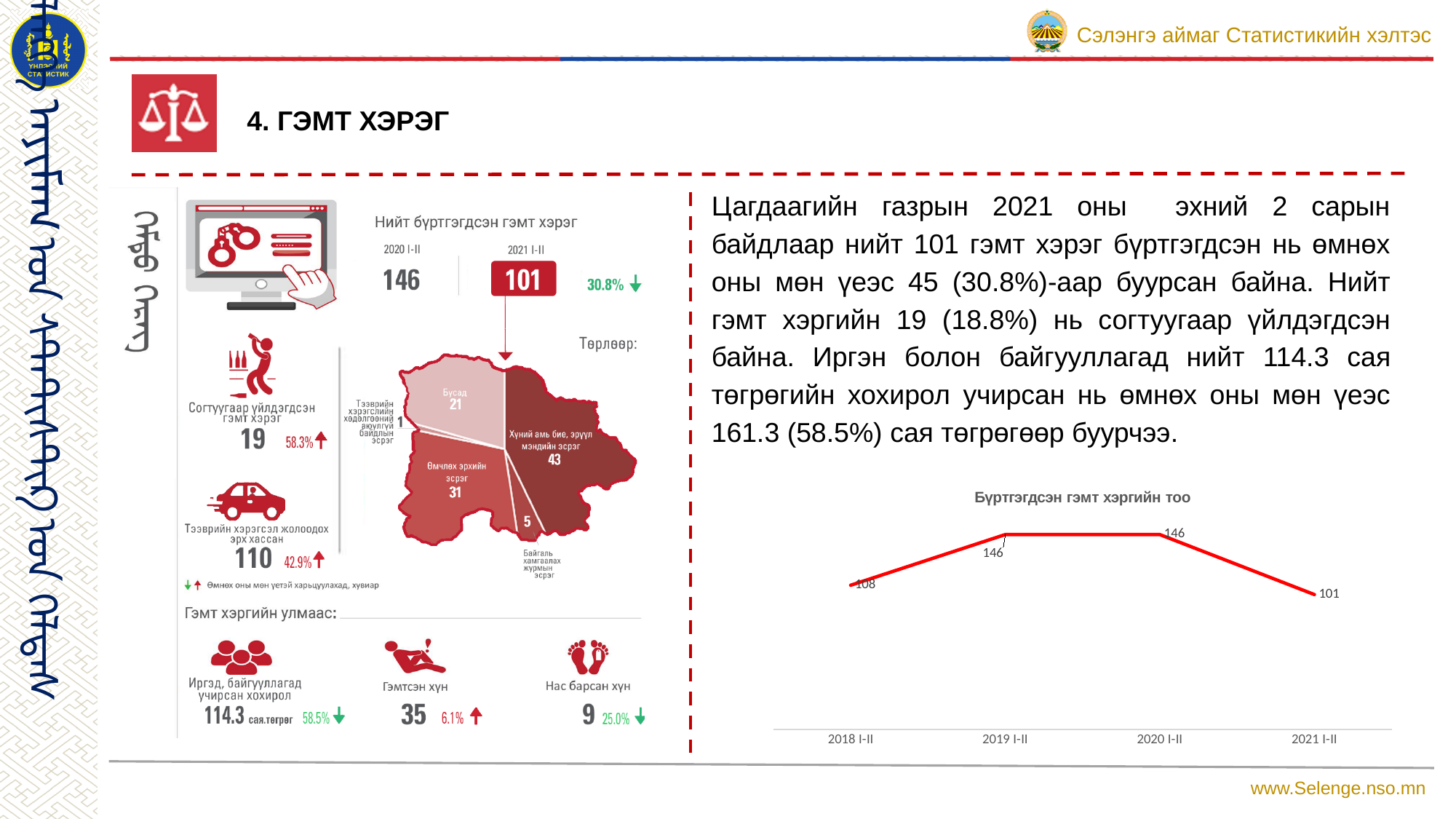
How many periods are plotted on the x axis of the 'Бүртгэгдсэн гэмт хэргийн тоо' chart? 4 In the 'Бүртгэгдсэн гэмт хэргийн тоо' chart, what is the difference between the values for 2019 I-II and 2018 I-II? 38 What kind of chart is the 'Бүртгэгдсэн гэмт хэргийн тоо' chart? line chart In the 'Бүртгэгдсэн гэмт хэргийн тоо' chart, what is the value for 2020 I-II? 146 In the 'Бүртгэгдсэн гэмт хэргийн тоо' chart, what is the value for 2018 I-II? 108 In the 'Бүртгэгдсэн гэмт хэргийн тоо' chart, which is larger: the value for 2018 I-II or 2021 I-II? 2018 I-II In the 'Бүртгэгдсэн гэмт хэргийн тоо' chart, what is the difference between the values for 2020 I-II and 2021 I-II? 45 In the 'Бүртгэгдсэн гэмт хэргийн тоо' chart, which period has the lowest value? 2021 I-II In the 'Бүртгэгдсэн гэмт хэргийн тоо' chart, what is the value for 2021 I-II? 101 In the 'Бүртгэгдсэн гэмт хэргийн тоо' chart, does the value rise or fall from 2020 I-II to 2021 I-II? fall What is the title of the line chart on the right side of the slide? Бүртгэгдсэн гэмт хэргийн тоо In the 'Бүртгэгдсэн гэмт хэргийн тоо' chart, does the value rise or fall from 2018 I-II to 2019 I-II? rise